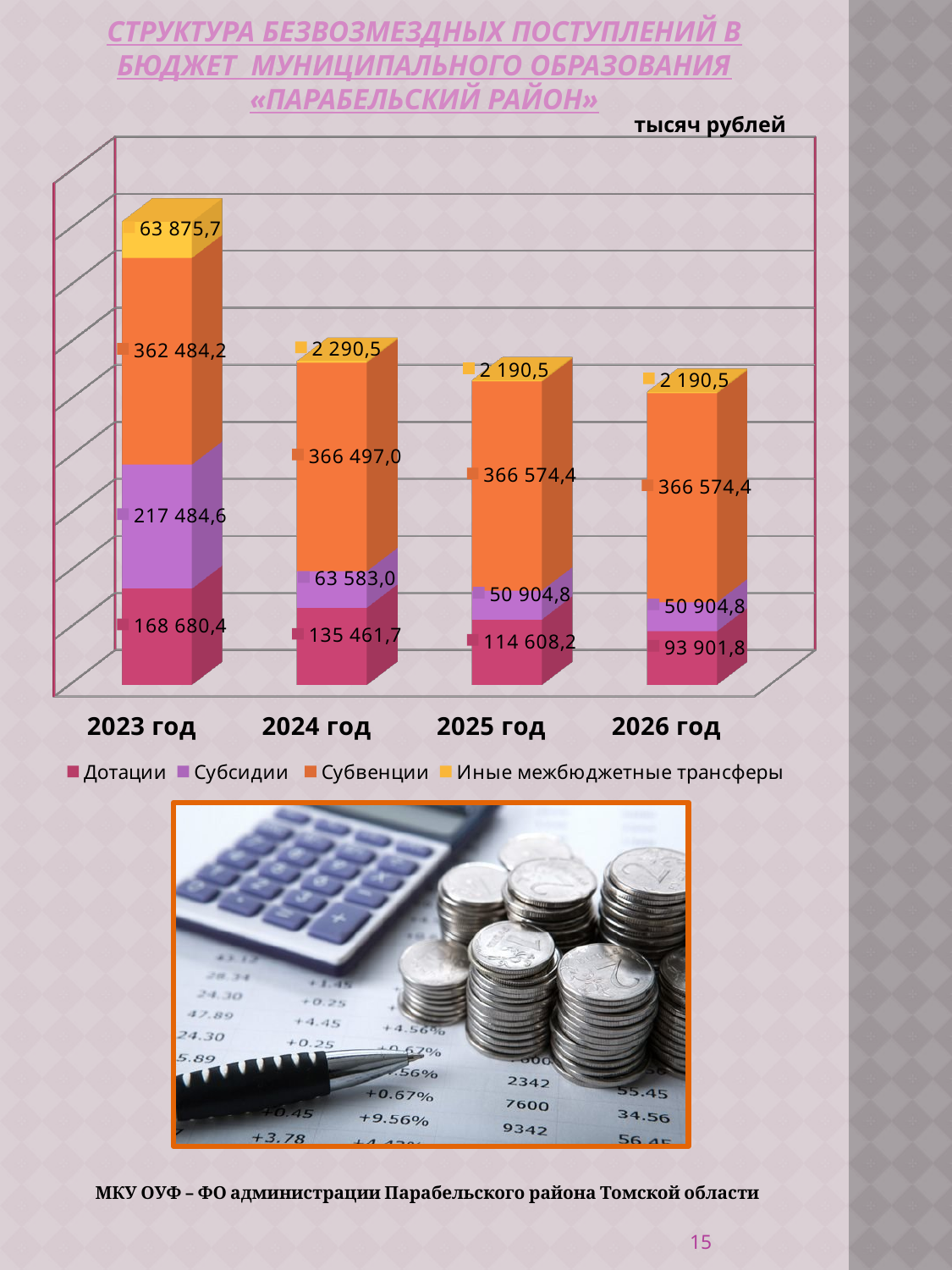
What is the difference between the Дотации values for 2023 год and 2024 год? 33 218,7 Which year has the lowest value of Дотации? 2026 год What is the value of Иные межбюджетные трансферы for 2025 год? 2 190,5 What is the total of the stacked bar for 2024 год? 567 832,2 Which year has the highest value of Дотации? 2023 год What is the value of Дотации for 2023 год? 168 680,4 Is the Субсидии value larger in 2023 год or in 2025 год? 2023 год How many series does the legend list? 4 What type of chart is shown on the slide? stacked bar chart What is the value of Субвенции for 2026 год? 366 574,4 How many years (categories) are shown on the x axis? 4 What is the value of Субсидии for 2024 год? 63 583,0